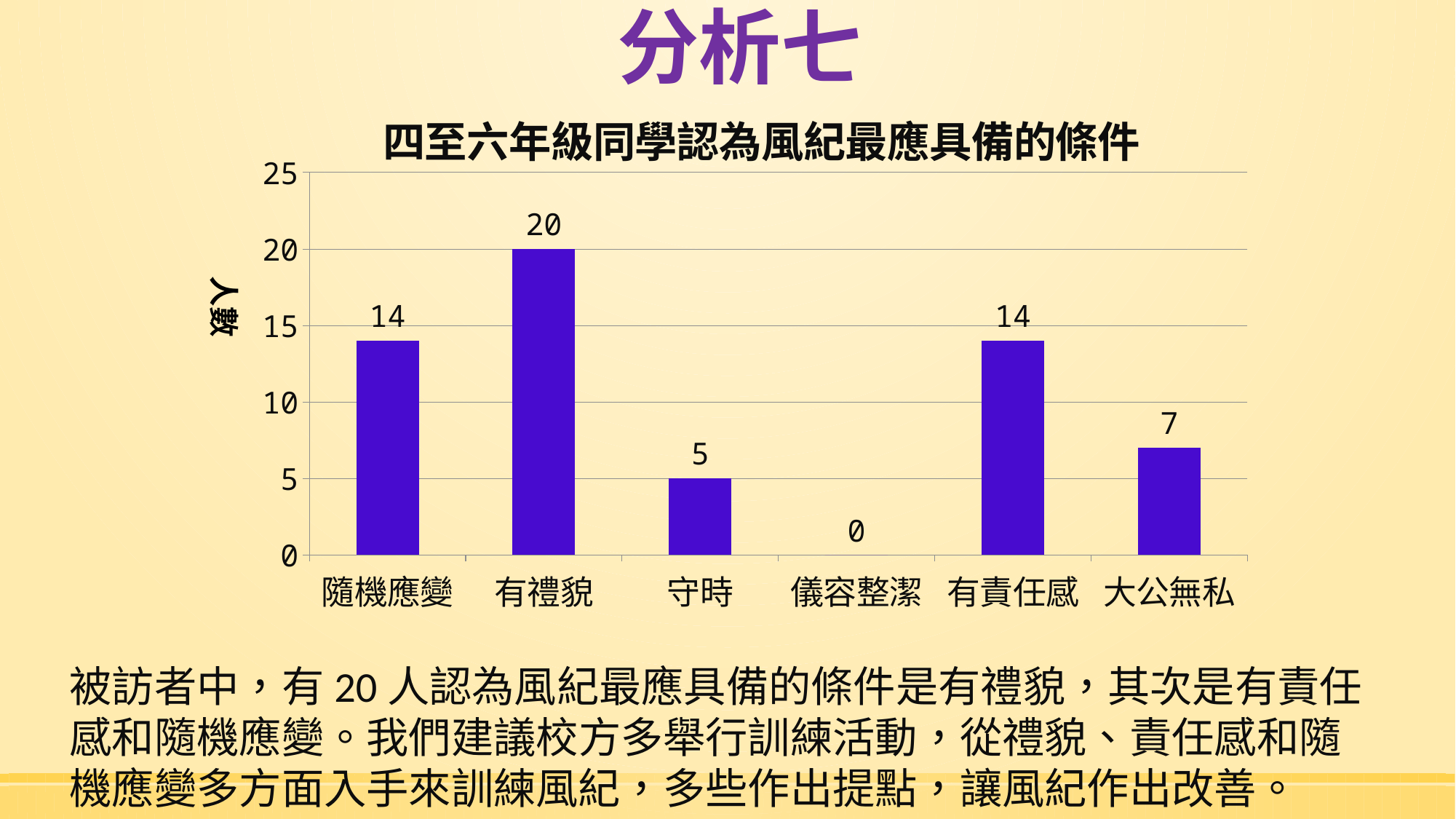
What is the title of the chart? 四至六年級同學認為風紀最應具備的條件 What is the value for 有禮貌? 20 What is the difference between the values for 有禮貌 and 有責任感? 6 What is the value for 儀容整潔? 0 How many categories are shown on the x axis? 6 What is the value for 守時? 5 Which is larger, the value for 守時 or the value for 大公無私? 大公無私 Which category has the highest value? 有禮貌 Which category has the lowest value? 儀容整潔 Is the value for 隨機應變 greater or less than 10? greater What kind of chart is shown? bar chart What is the value for 大公無私? 7